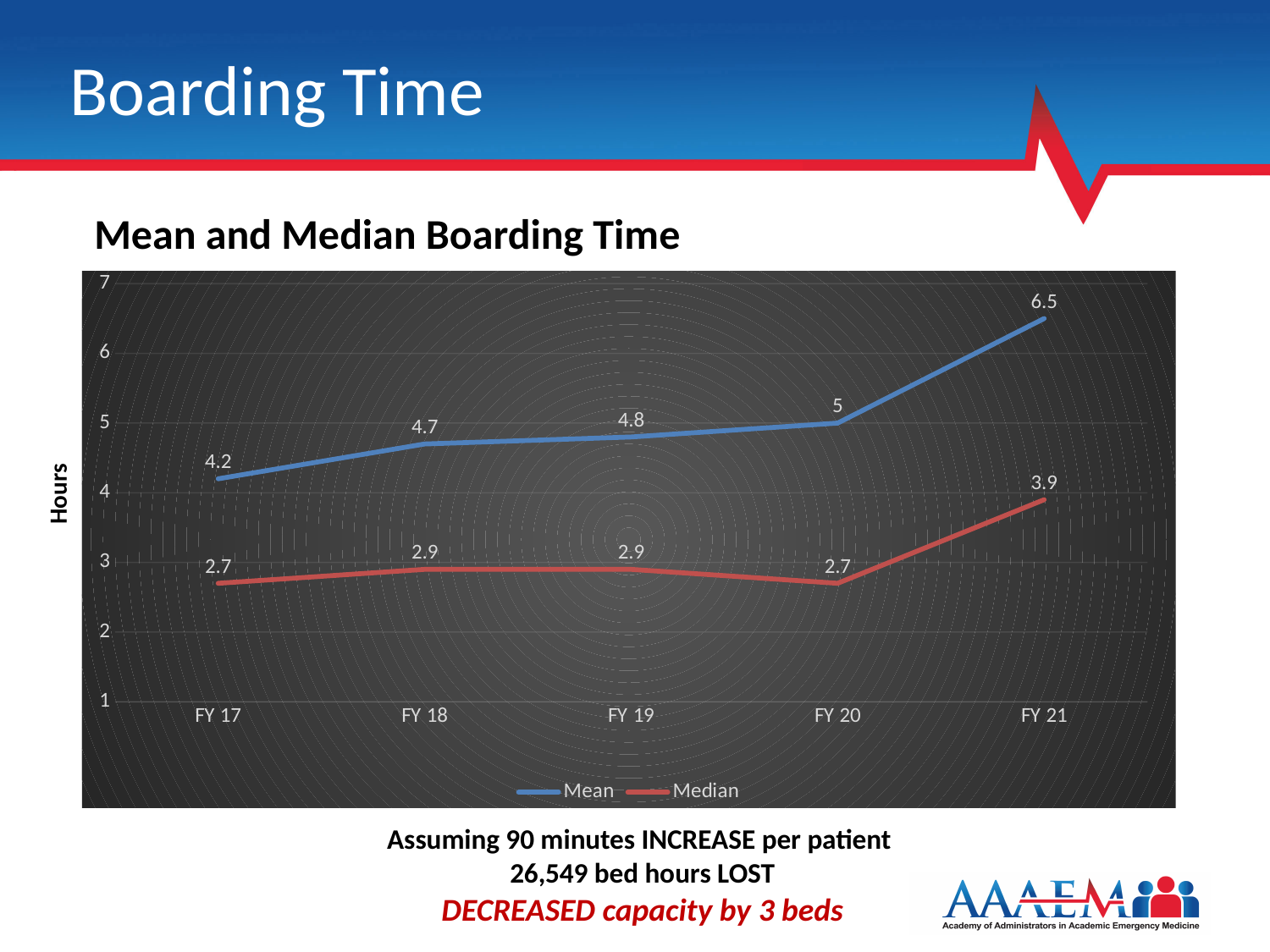
Which fiscal year has the highest Mean boarding time? FY 21 What is the difference between the Mean and Median boarding time in FY 21? 2.6 How many fiscal years are plotted on the x axis? 5 What is the Mean boarding time for FY 17? 4.2 What kind of chart is shown on the slide? Line chart Does the Mean boarding time rise or fall from FY 17 to FY 21? Rise What is the Median boarding time for FY 18? 2.9 How many series does the legend list? 2 Which fiscal year has the lowest Mean boarding time? FY 17 Which is larger, the Mean boarding time in FY 19 or in FY 20? FY 20 What is the Mean boarding time for FY 21? 6.5 By how much did the Mean boarding time increase from FY 20 to FY 21? 1.5